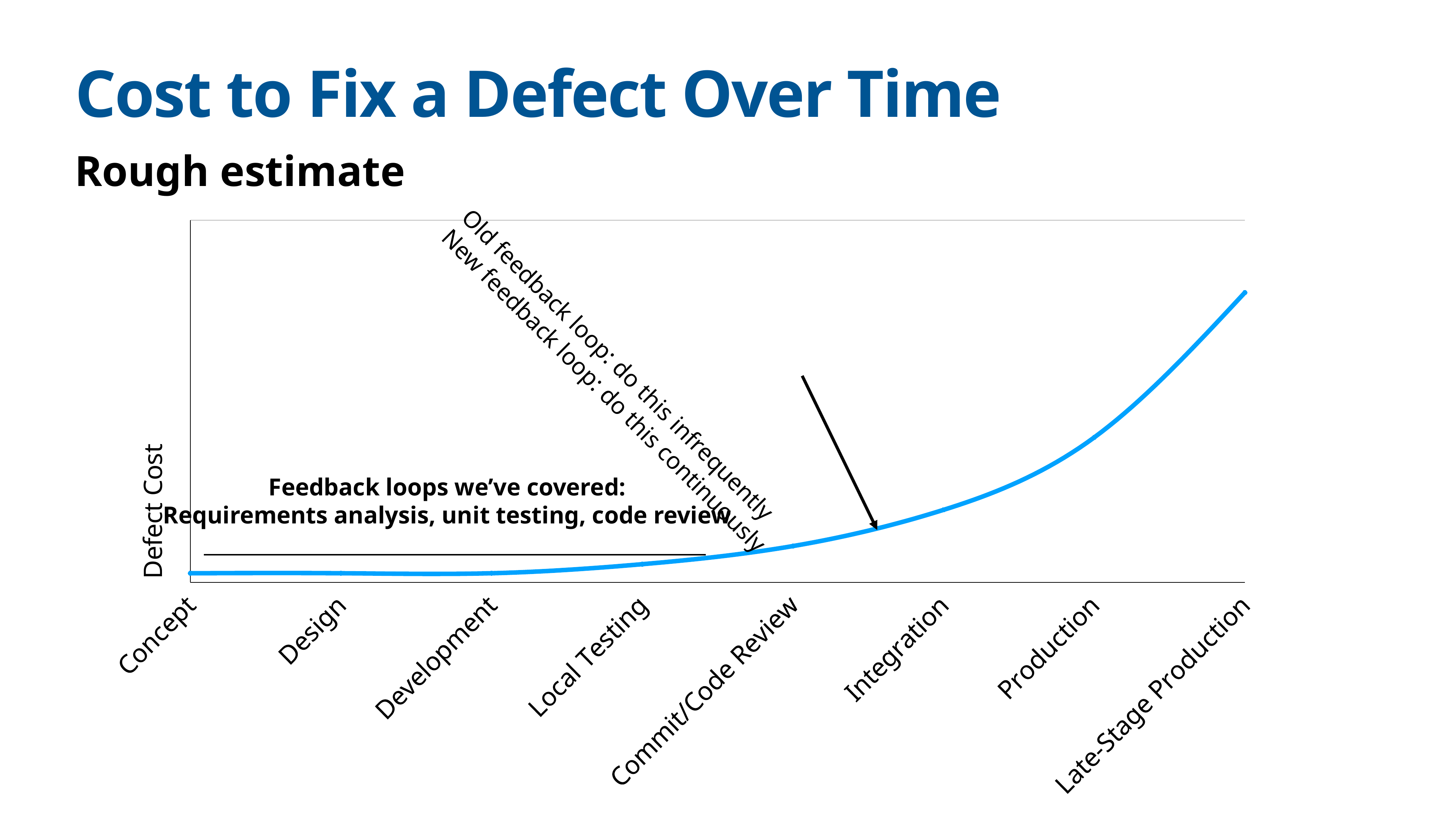
How many categories are shown on the x axis of the chart? 8 What is the title of the chart on the slide? Cost to Fix a Defect Over Time Which has a higher defect cost on the chart, Late-Stage Production or Concept? Late-Stage Production What is the label on the y axis of the chart? Defect Cost What is the first category on the x axis of the chart? Concept Does the defect cost rise or fall as you move from Concept to Late-Stage Production along the x axis? Rise Which has a higher defect cost on the chart, Production or Integration? Production What kind of chart is shown on the slide? Line chart Which category has the highest defect cost on the chart? Late-Stage Production What is the last category on the x axis of the chart? Late-Stage Production Which has a higher defect cost on the chart, Integration or Local Testing? Integration